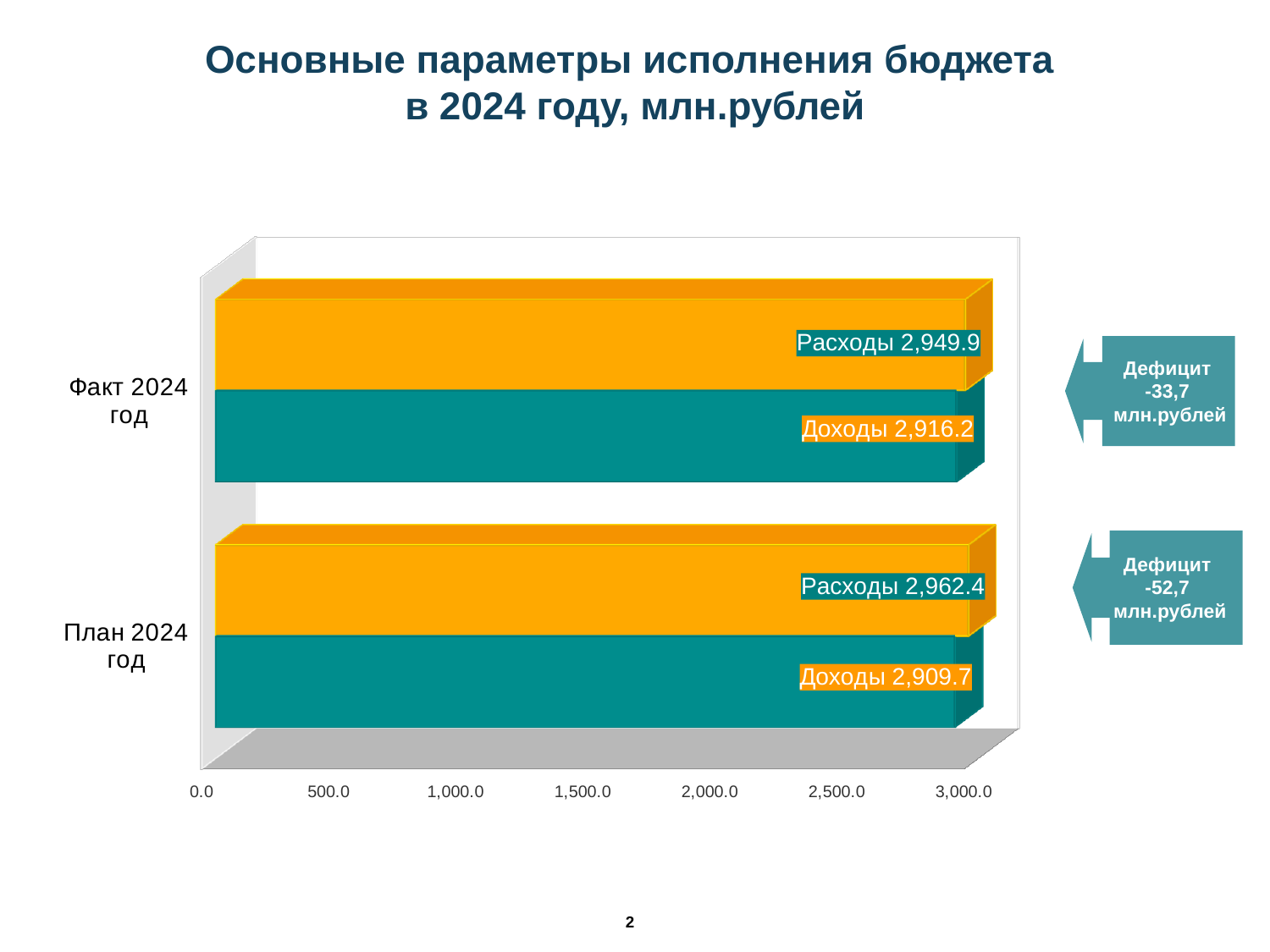
What type of chart is shown on the slide? bar chart What is the value of Доходы for План 2024 год? 2,909.7 How many categories are shown on the vertical axis of the chart? 2 Which is larger for Факт 2024 год: Расходы or Доходы? Расходы What is the difference between Расходы and Доходы for Факт 2024 год? 33.7 What is the difference between Расходы and Доходы for План 2024 год? 52.7 Which bar has the lowest value on the chart? Доходы, План 2024 год (2,909.7) What deficit is shown in the callout next to Факт 2024 год? -33,7 млн.рублей What is the value of Доходы for Факт 2024 год? 2,916.2 What is the value of Расходы for Факт 2024 год? 2,949.9 What is the value of Расходы for План 2024 год? 2,962.4 Which bar has the highest value on the chart? Расходы, План 2024 год (2,962.4)